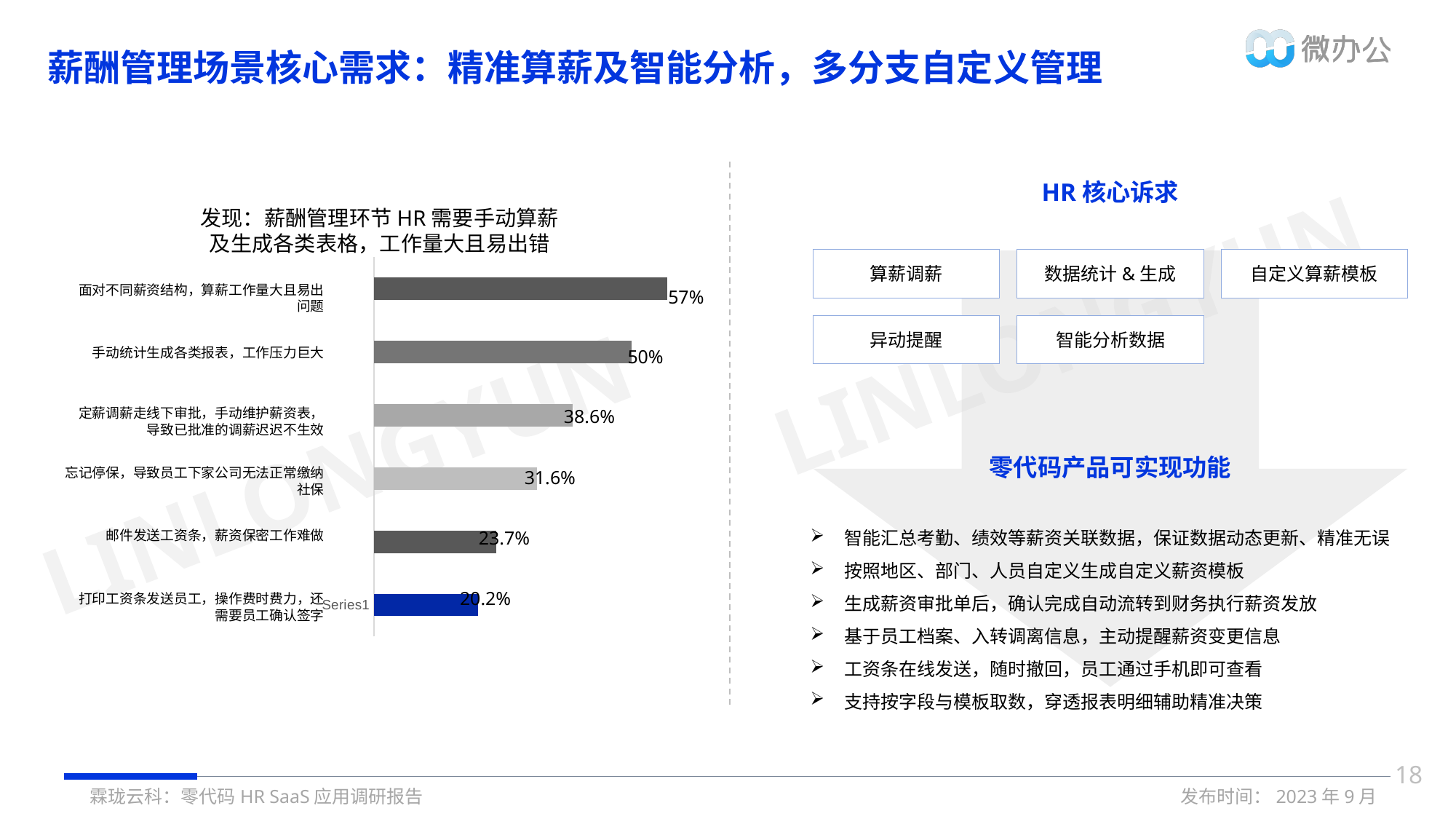
What is the difference between the values for "面对不同薪资结构，算薪工作量大且易出问题" and "手动统计生成各类报表，工作压力巨大"? 7% How many categories are shown in the chart? 6 Which is larger: the value for "邮件发送工资条，薪资保密工作难做" or the value for "打印工资条发送员工，操作费时费力，还需要员工确认签字"? 邮件发送工资条，薪资保密工作难做 What is the value for "邮件发送工资条，薪资保密工作难做"? 23.7% Which category has the highest value? 面对不同薪资结构，算薪工作量大且易出问题 What is the value for "定薪调薪走线下审批，手动维护薪资表，导致已批准的调薪迟迟不生效"? 38.6% What is the value for "手动统计生成各类报表，工作压力巨大"? 50% What is the title of the chart? 发现：薪酬管理环节 HR 需要手动算薪及生成各类表格，工作量大且易出错 What is the value for "忘记停保，导致员工下家公司无法正常缴纳社保"? 31.6% Which category has the lowest value? 打印工资条发送员工，操作费时费力，还需要员工确认签字 What kind of chart is shown on the slide? Bar chart What is the difference between the values for "定薪调薪走线下审批，手动维护薪资表，导致已批准的调薪迟迟不生效" and "忘记停保，导致员工下家公司无法正常缴纳社保"? 7%